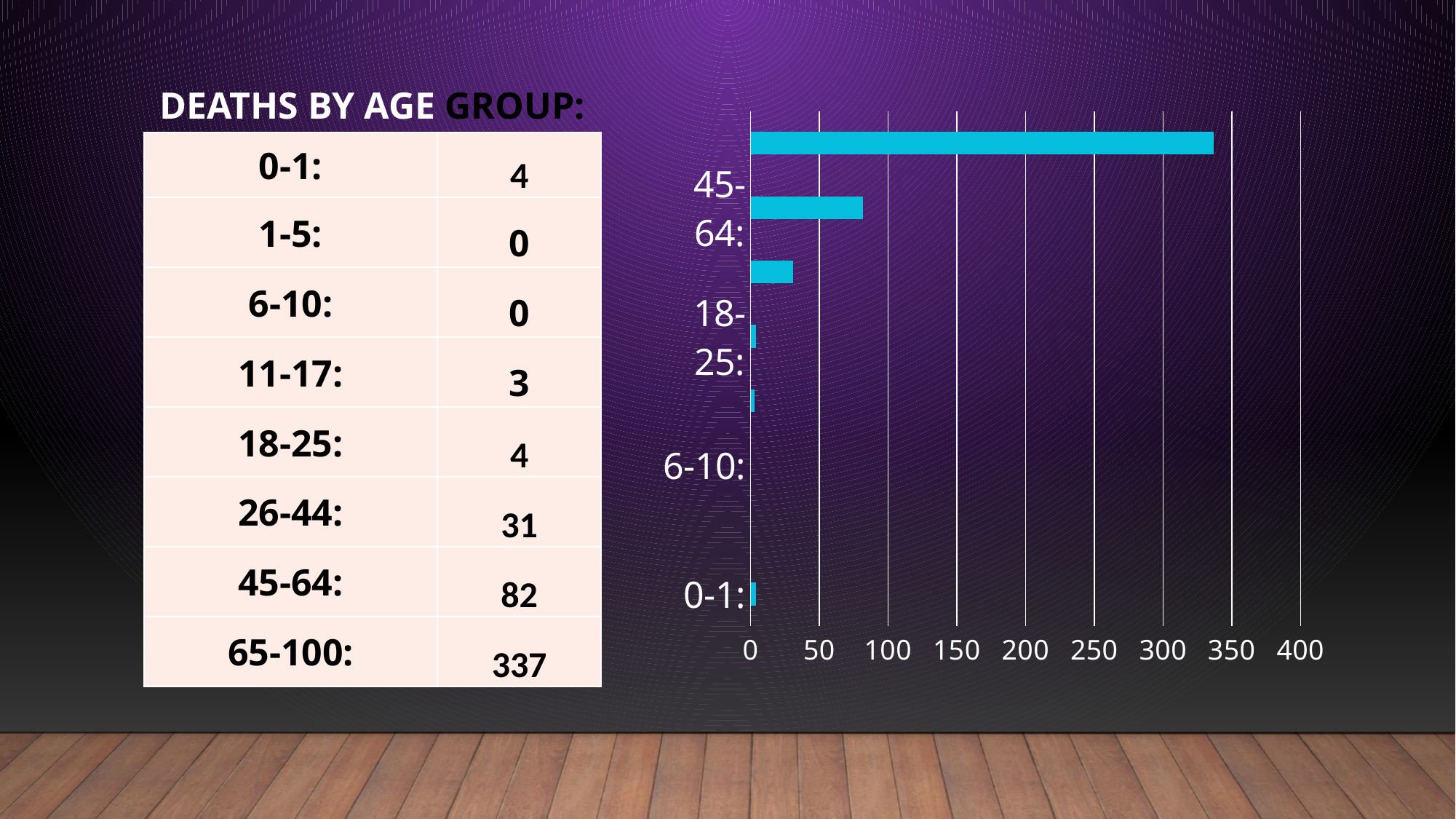
Which has more deaths, the 45-64 age group or the 26-44 age group? 45-64 How many deaths are recorded for the 45-64 age group? 82 What is the difference in deaths between the 65-100 and 45-64 age groups? 255 Is the value for the 45-64 age group greater or less than 100? less What kind of chart is shown on the slide? bar chart What is the title shown above the table on the slide? DEATHS BY AGE GROUP: How many deaths are recorded for the 65-100 age group? 337 Which age group has the highest number of deaths in the chart? 65-100 How many age groups are listed on the slide? 8 Is the value for the 26-44 age group greater or less than 50? less How many deaths are recorded for the 26-44 age group? 31 Is the value for the 65-100 age group greater or less than 300? greater